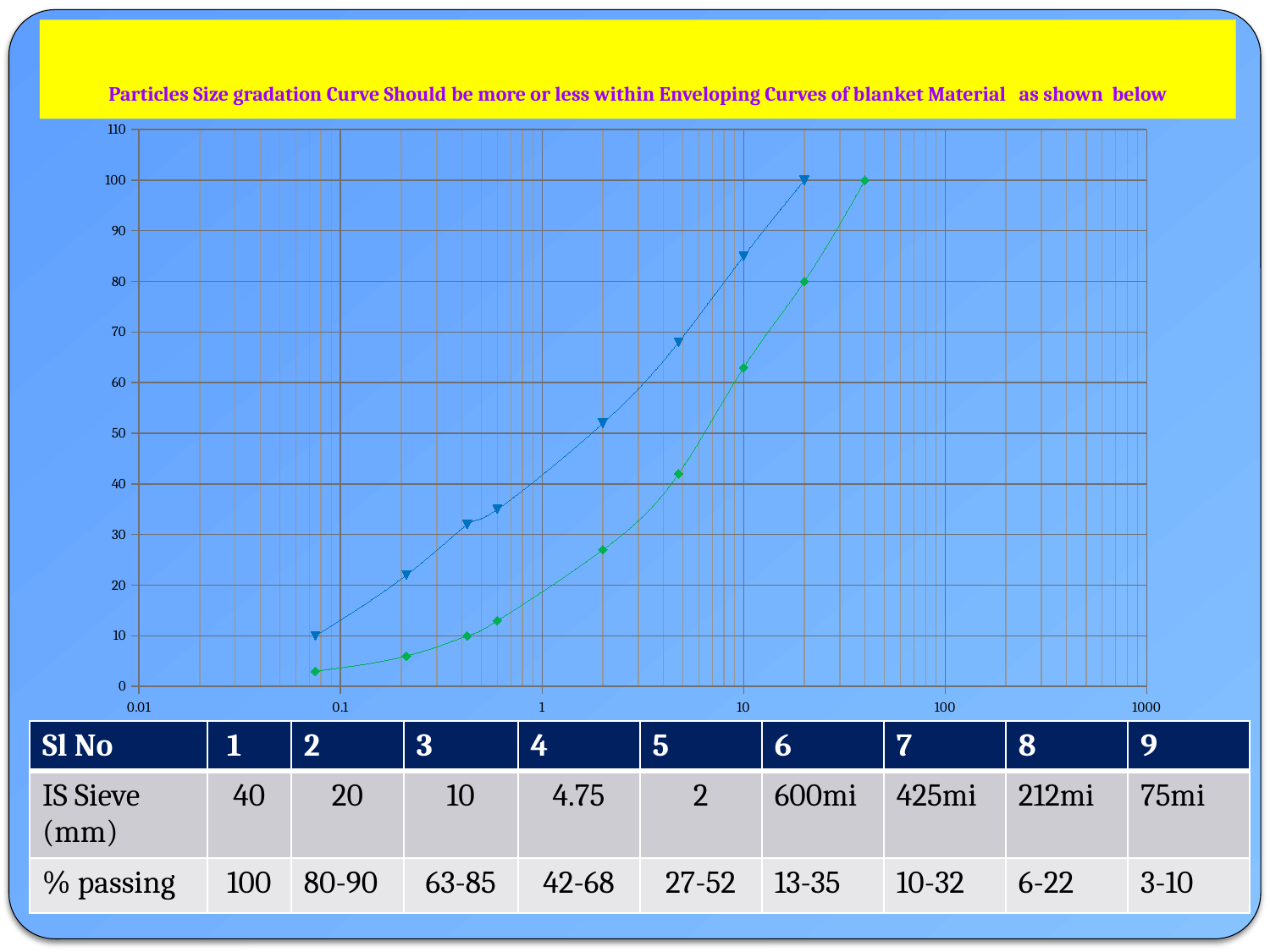
What is the value of the blue line at its leftmost point (x ≈ 0.075)? 10 How many data points are plotted on the green line? 9 What is the range of the x-axis shown on the chart? 0.01 to 1000 Is the value of the green line at x = 10 greater or less than 70? less How many data points are plotted on the blue line? 8 What is the highest value reached by the green line? 100 Is the value of the blue line at x = 2 greater or less than 40? greater How many lines (series) are plotted on the chart? 2 What kind of chart is shown on the slide? line chart Do the values on the blue line rise or fall as the x-axis value increases? rise At x = 10, which line has the higher value, the blue line or the green line? blue line What is the value of the green line at x = 20? 80